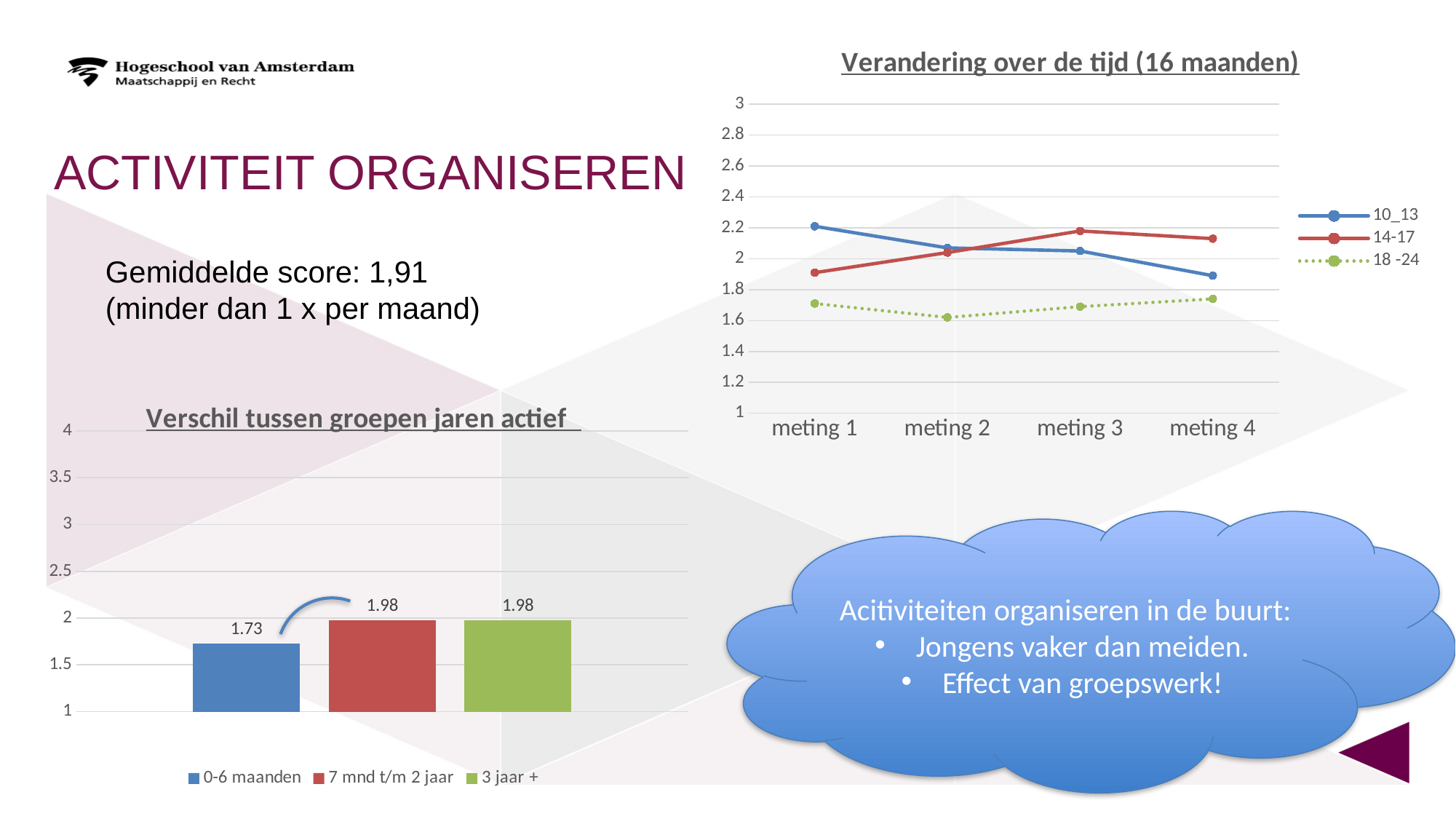
In the line chart 'Verandering over de tijd (16 maanden)', does the 10_13 series rise or fall from meting 1 to meting 4? fall In the bar chart 'Verschil tussen groepen jaren actief', which group has the lowest value? 0-6 maanden In the bar chart 'Verschil tussen groepen jaren actief', what is the value for 0-6 maanden? 1.73 What kind of chart is 'Verandering over de tijd (16 maanden)'? line chart In the line chart 'Verandering over de tijd (16 maanden)', is the value for 18 -24 at meting 2 greater or less than 1.8? less In the bar chart 'Verschil tussen groepen jaren actief', what is the difference between the values for 7 mnd t/m 2 jaar and 0-6 maanden? 0.25 In the bar chart 'Verschil tussen groepen jaren actief', how many entries does the legend list? 3 In the bar chart 'Verschil tussen groepen jaren actief', how many bars are shown? 3 In the line chart 'Verandering over de tijd (16 maanden)', how many measurement points are on the x axis? 4 In the line chart 'Verandering over de tijd (16 maanden)', how many series does the legend list? 3 In the line chart 'Verandering over de tijd (16 maanden)', which series is higher at meting 4: 10_13 or 14-17? 14-17 In the bar chart 'Verschil tussen groepen jaren actief', what is the value for 3 jaar +? 1.98